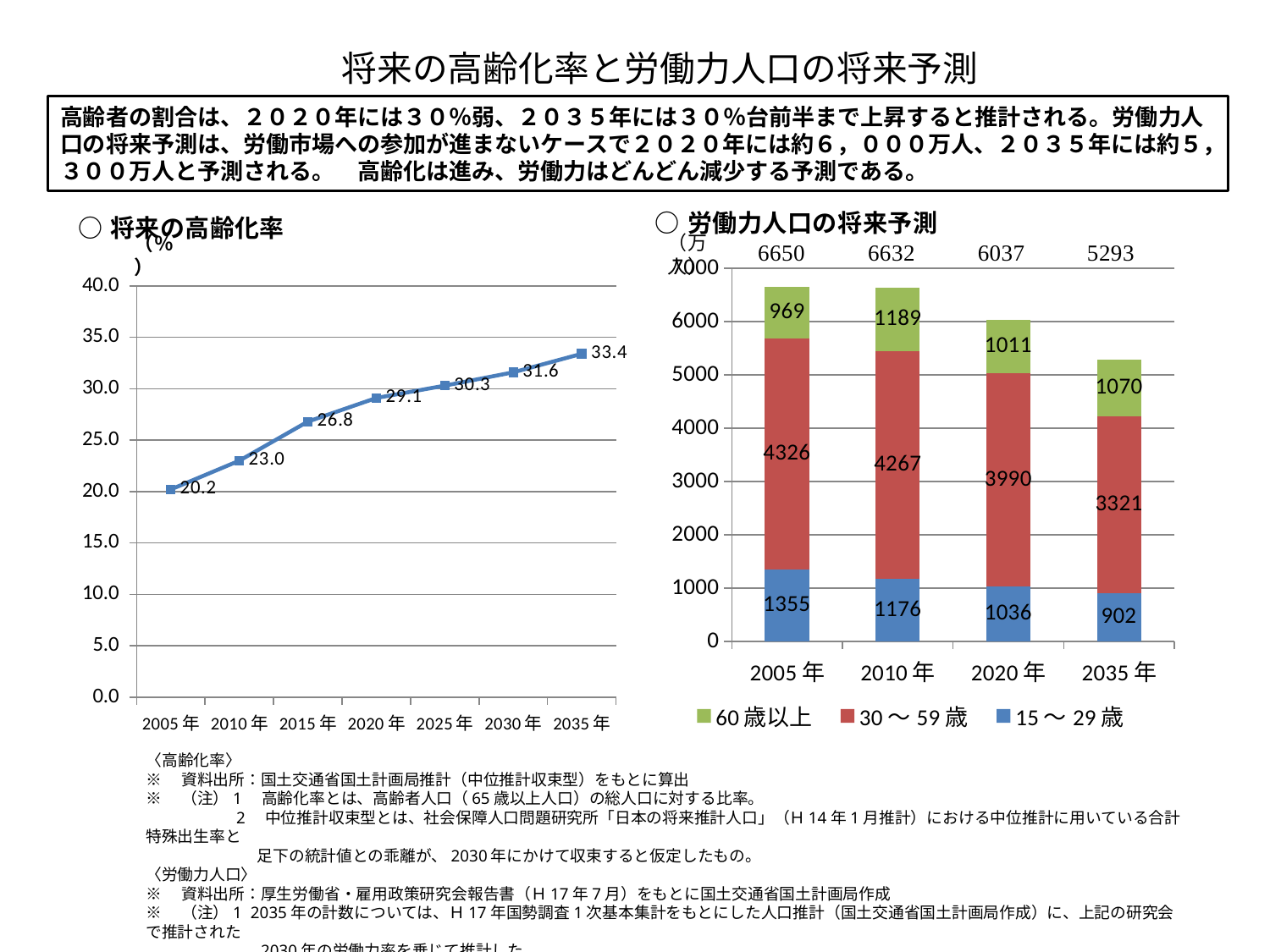
What kind of chart is the 労働力人口の将来予測 chart on the right? stacked bar chart In the 労働力人口の将来予測 chart on the right, what is the difference between the 15～29歳 values for 2005年 and 2010年? 179 In the 将来の高齢化率 chart on the left, what is the value for 2035年? 33.4 In the 労働力人口の将来予測 chart on the right, which is larger: the 60歳以上 value for 2010年 or for 2035年? 2010年 In the 労働力人口の将来予測 chart on the right, which year has the lowest 15～29歳 value? 2035年 In the 労働力人口の将来予測 chart on the right, what is the total of the stacked bar for 2035年? 5293 In the 労働力人口の将来予測 chart on the right, how many series does the legend list? 3 In the 将来の高齢化率 chart on the left, do the values rise or fall from 2005年 to 2035年? rise In the 将来の高齢化率 chart on the left, what is the difference between the values for 2035年 and 2005年? 13.2 In the 労働力人口の将来予測 chart on the right, what is the value of the 30～59歳 segment for 2020年? 3990 In the 将来の高齢化率 chart on the left, what is the value for 2020年? 29.1 In the 将来の高齢化率 chart on the left, how many data points are plotted? 7